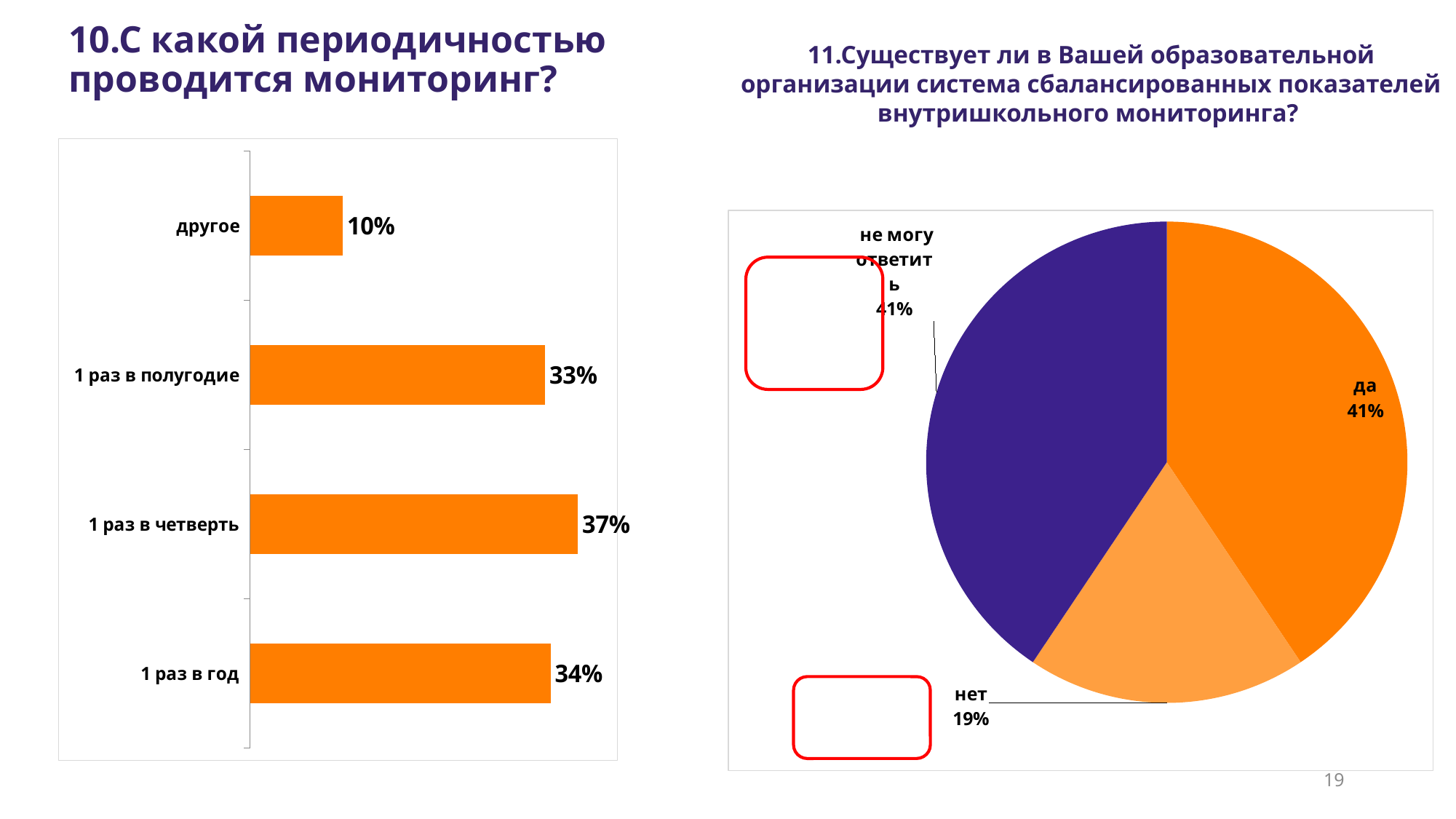
In the bar chart on the left (question 10), what is the difference between the values for "1 раз в год" and "1 раз в полугодие"? 1% In the pie chart on the right (question 11), what share of the pie is "нет"? 19% How many categories does the bar chart on the left (question 10) show? 4 In the bar chart on the left (question 10), which category has the highest value? 1 раз в четверть In the bar chart on the left (question 10), which is larger: the value for "1 раз в полугодие" or the value for "другое"? 1 раз в полугодие In the bar chart on the left (question 10), which category has the lowest value? другое In the pie chart on the right (question 11), what is the value for "да"? 41% In the pie chart on the right (question 11), which slice is the smallest? нет In the bar chart on the left (question 10), what is the value for "1 раз в четверть"? 37% What kind of chart is shown on the right of the slide (question 11)? pie chart What kind of chart is shown on the left of the slide (question 10)? bar chart In the bar chart on the left (question 10), what is the value for "другое"? 10%